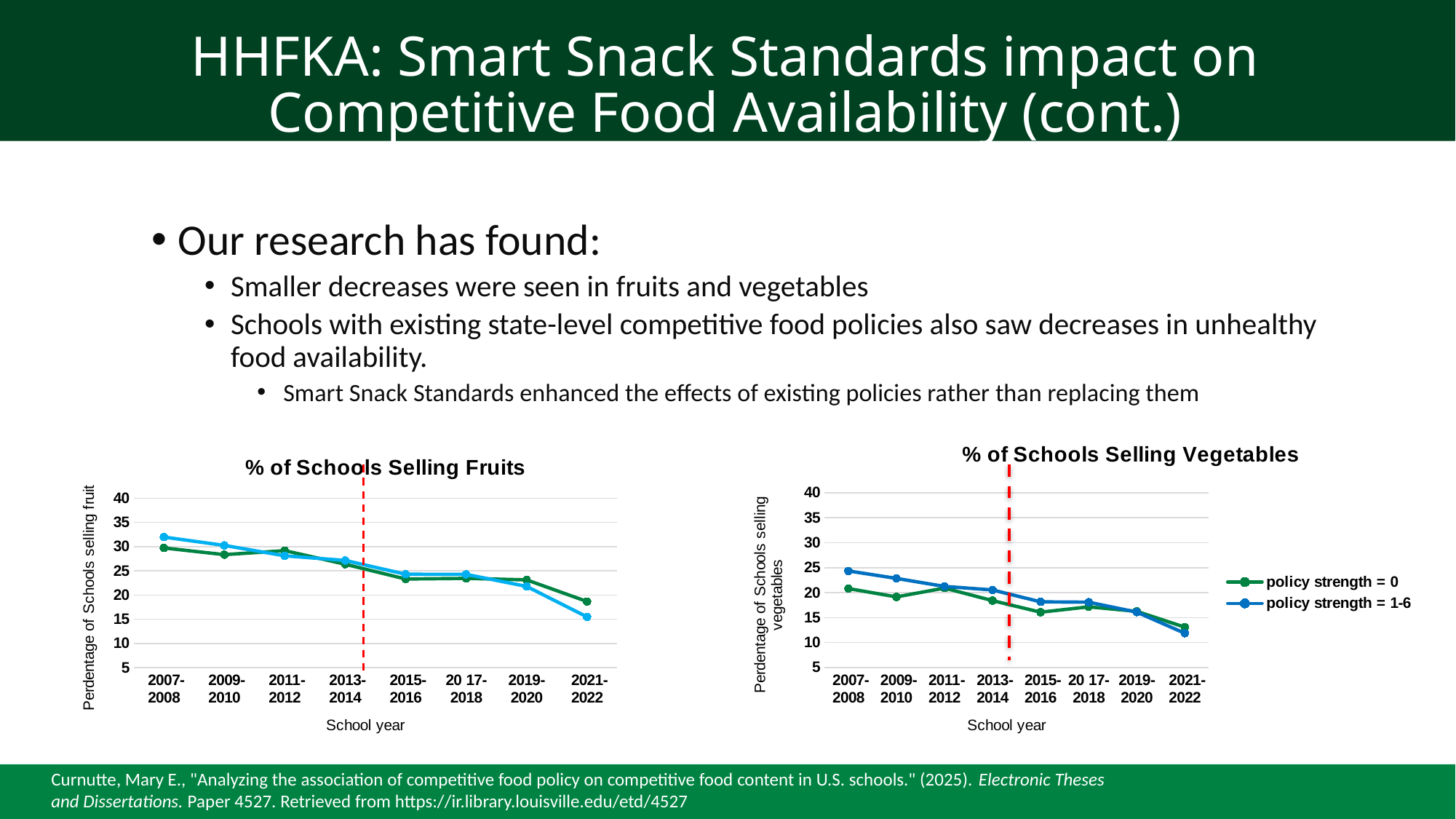
How many series does the legend of the '% of Schools Selling Vegetables' chart list? 2 In the '% of Schools Selling Vegetables' chart, which series has the higher value in 2007-2008, policy strength = 0 or policy strength = 1-6? policy strength = 1-6 In the '% of Schools Selling Fruits' chart, which school year has the highest value on the blue line? 2007-2008 In the '% of Schools Selling Vegetables' chart, do the values for policy strength = 0 rise or fall from 2007-2008 to 2021-2022? fall How many school years are shown on the x axis of the '% of Schools Selling Vegetables' chart? 8 In the '% of Schools Selling Vegetables' chart, is the value for policy strength = 1-6 in 2021-2022 greater or less than 15? less In the '% of Schools Selling Fruits' chart, is the value of the blue line for 2007-2008 greater or less than 30? greater What is the x-axis label of the '% of Schools Selling Fruits' chart? School year What is the title of the chart on the right side of the slide? % of Schools Selling Vegetables In the '% of Schools Selling Vegetables' chart, is the value for policy strength = 0 in 2015-2016 greater or less than 20? less What kind of chart is the '% of Schools Selling Fruits' chart? line chart